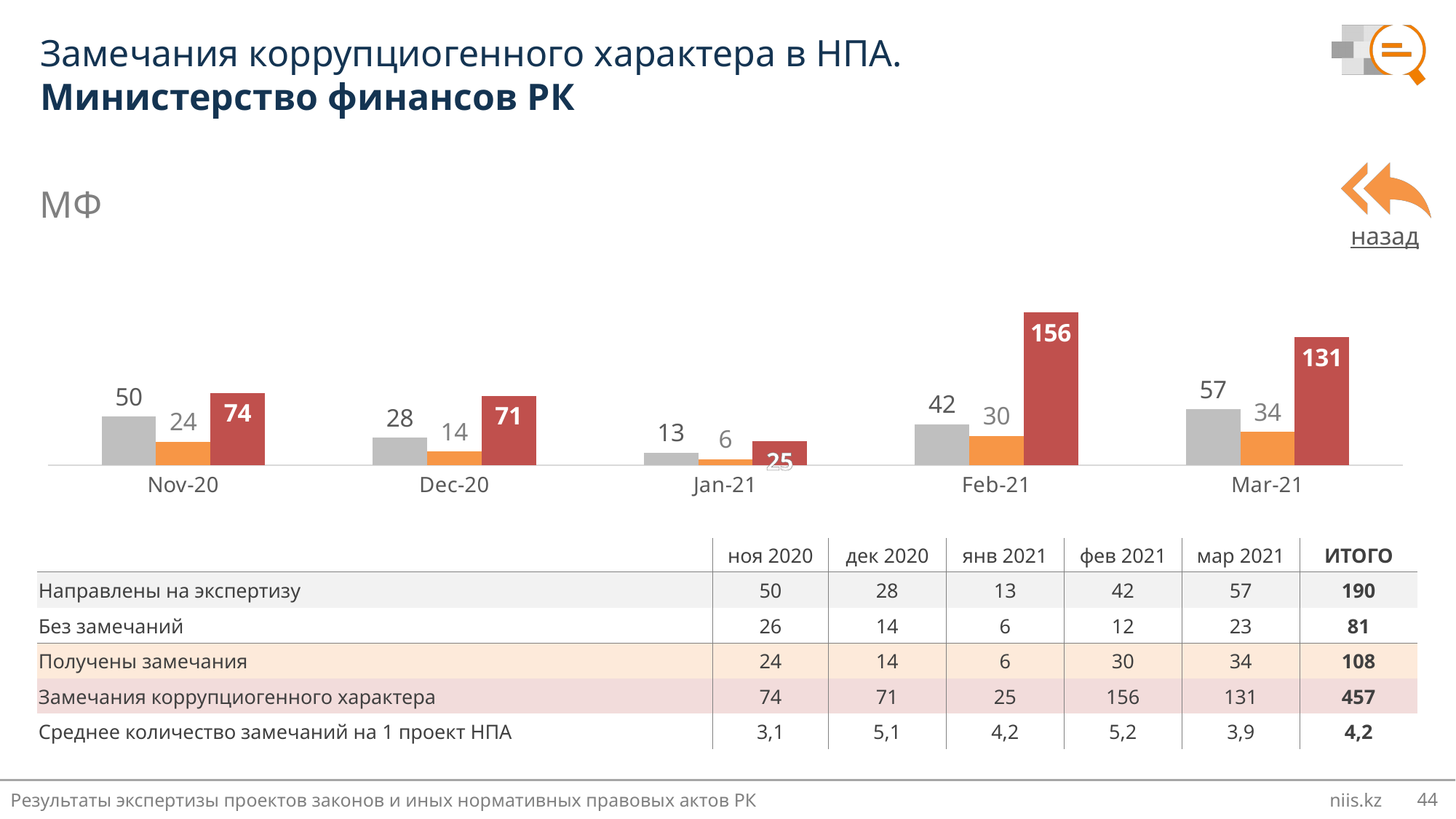
Does the red bar rise or fall from Nov-20 to Jan-21? fall In which month is the grey bar (Направлены на экспертизу) lowest? Jan-21 What is the value of the grey bar for Mar-21? 57 How many bars are shown for each month in the chart? 3 Which is larger: the grey bar for Nov-20 or the grey bar for Feb-21? Nov-20 In which month is the red bar (Замечания коррупциогенного характера) highest? Feb-21 What is the value of the orange bar for Dec-20? 14 How many months are shown on the x axis of the chart? 5 What type of chart is shown on the slide? bar chart What is the value of the red bar for Feb-21? 156 What is the difference between the red bar values for Feb-21 and Mar-21? 25 What colour is the bar representing Замечания коррупциогенного характера? red